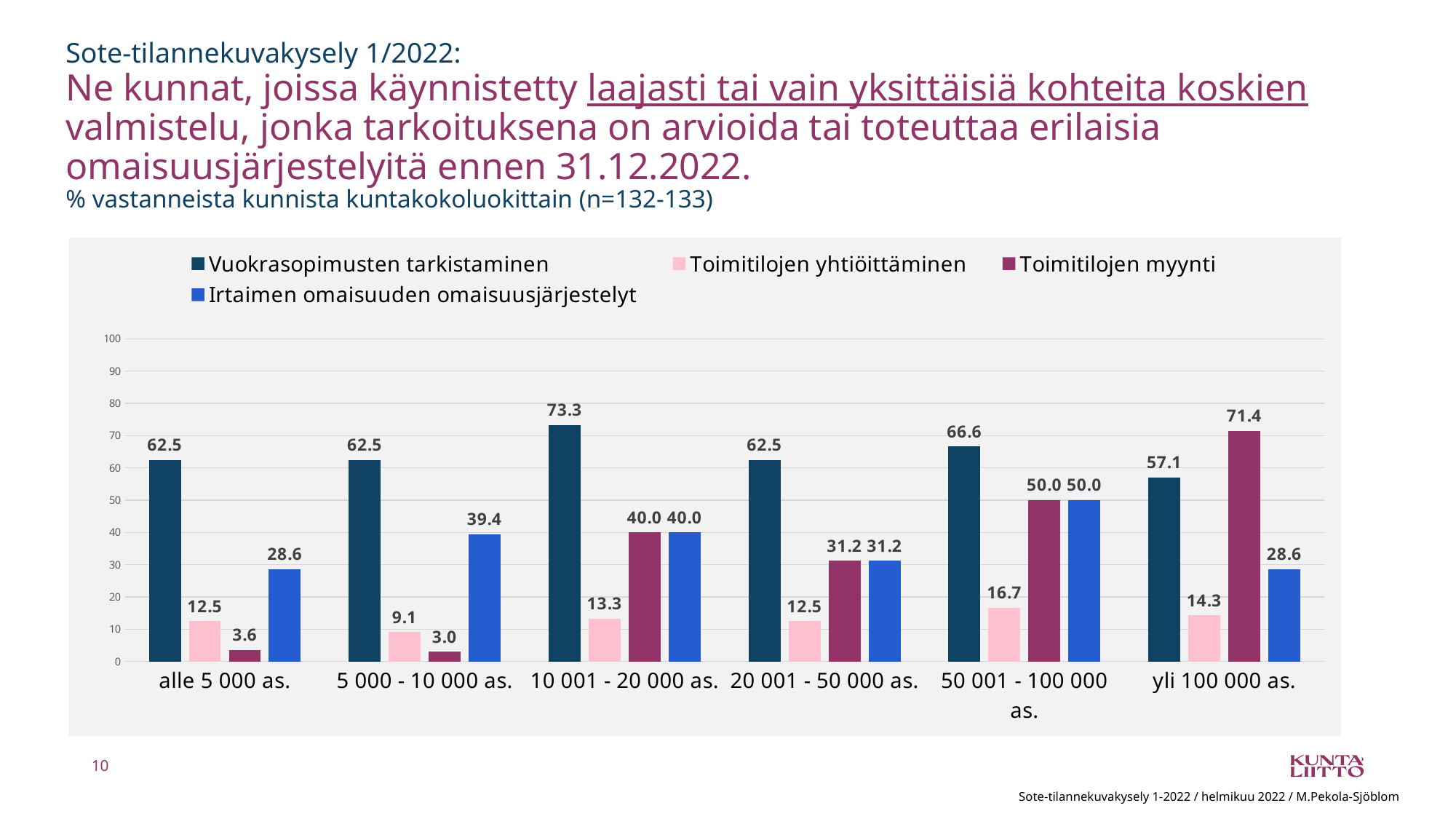
What is the value for Toimitilojen yhtiöittäminen in the 5 000 - 10 000 as. category? 9.1 Is the value for Irtaimen omaisuuden omaisuusjärjestelyt in the 5 000 - 10 000 as. category greater or less than 30? greater What is the difference between the Toimitilojen myynti value and the Toimitilojen yhtiöittäminen value in the yli 100 000 as. category? 57.1 How many series does the legend list? 4 What is the value for Irtaimen omaisuuden omaisuusjärjestelyt in the 50 001 - 100 000 as. category? 50.0 What kind of chart is shown on the slide? bar chart What is the value for Toimitilojen myynti in the yli 100 000 as. category? 71.4 What is the value for Vuokrasopimusten tarkistaminen in the 10 001 - 20 000 as. category? 73.3 How many municipality size categories are shown on the x axis? 6 In the yli 100 000 as. category, which is larger: Vuokrasopimusten tarkistaminen or Toimitilojen myynti? Toimitilojen myynti In which category is the value for Toimitilojen myynti lowest? 5 000 - 10 000 as. In which category is the value for Vuokrasopimusten tarkistaminen highest? 10 001 - 20 000 as.